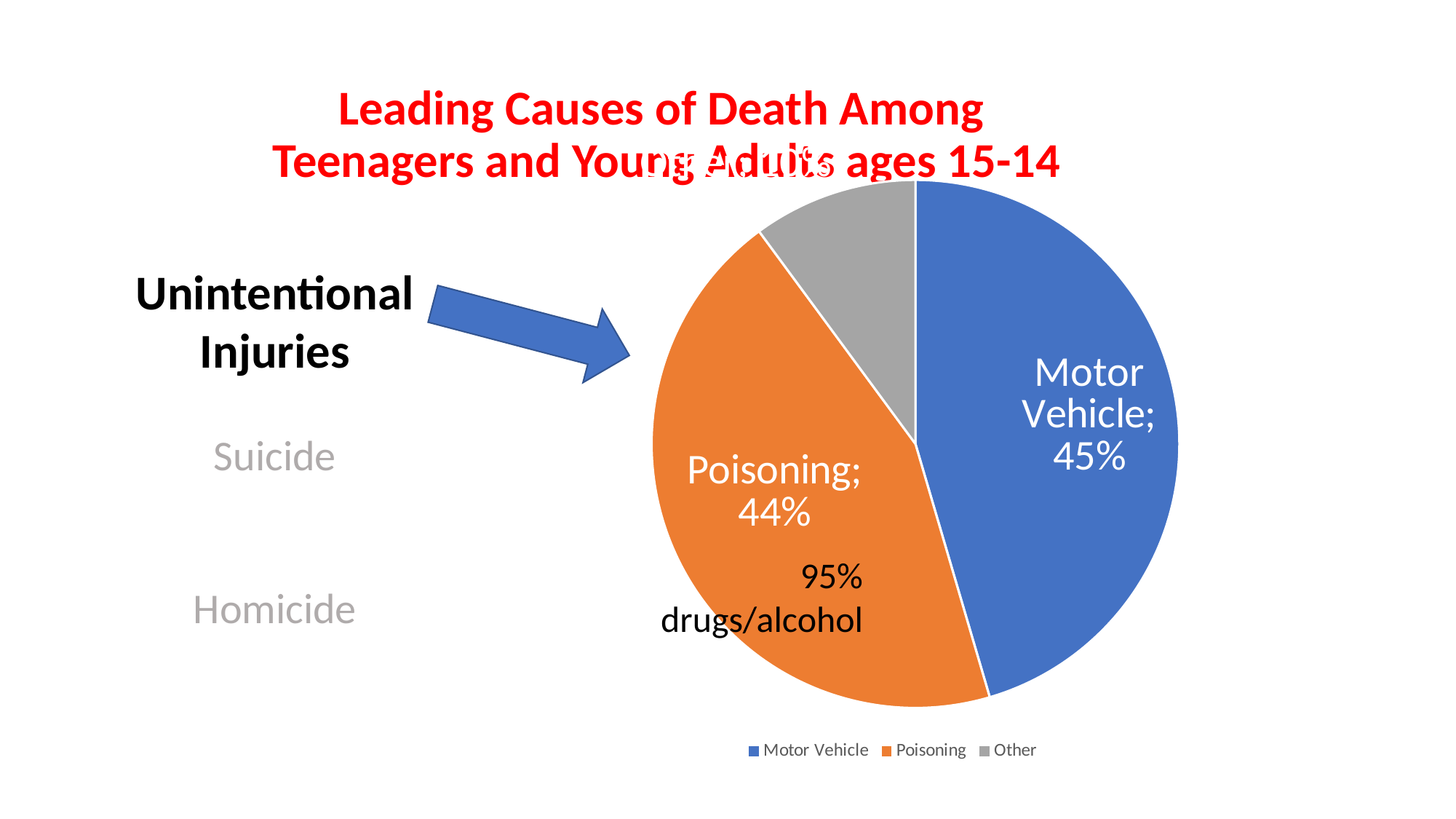
How many slices does the pie chart have? 3 What annotation is written on the Poisoning slice below its percentage label? 95% drugs/alcohol What kind of chart is shown on the slide? pie chart What percentage of the pie chart is labelled for Poisoning? 44% What percentage of the pie chart is labelled for Motor Vehicle? 45% What colour is the Poisoning slice in the pie chart? orange What is the difference between the Motor Vehicle share and the Poisoning share? 1% How many entries does the chart legend list? 3 What is the combined share of the Motor Vehicle and Poisoning slices? 89% Which slice of the pie chart is the smallest? Other Which is larger, the Motor Vehicle slice or the Poisoning slice? Motor Vehicle Which slice of the pie chart is the largest? Motor Vehicle